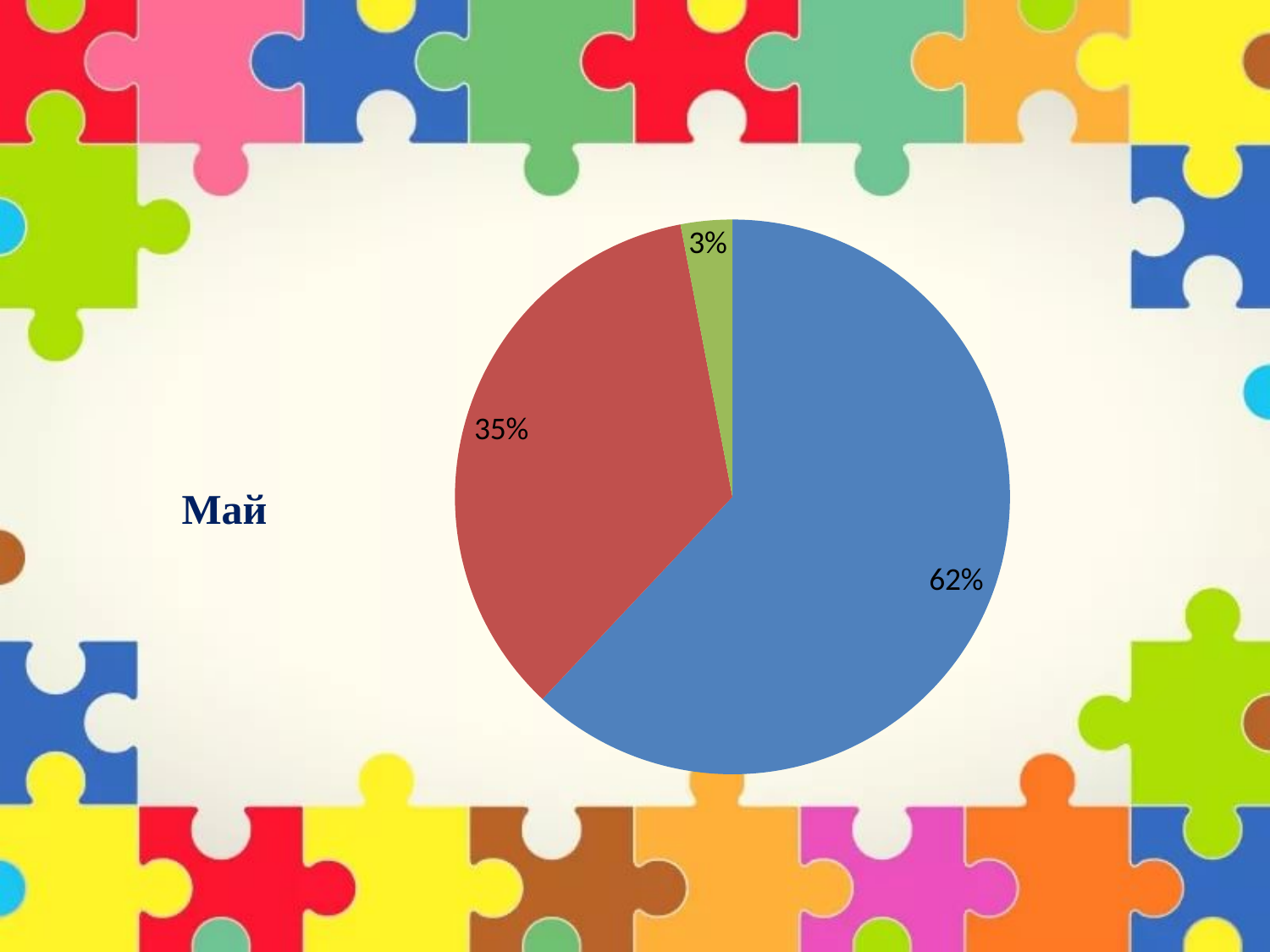
What is the difference in percentage points between the blue slice and the red slice? 27 Is the blue slice more or less than half of the pie? more What kind of chart is shown on the slide? pie chart Which is larger, the red slice or the green slice? red slice What percentage is shown on the green slice of the pie chart? 3% Which colour slice is the smallest in the pie chart? green What word is written to the left of the pie chart? Май What is the difference in percentage points between the red slice and the green slice? 32 What percentage is shown on the red slice of the pie chart? 35% What percentage is shown on the blue slice of the pie chart? 62% How many slices does the pie chart have? 3 Which colour slice is the largest in the pie chart? blue